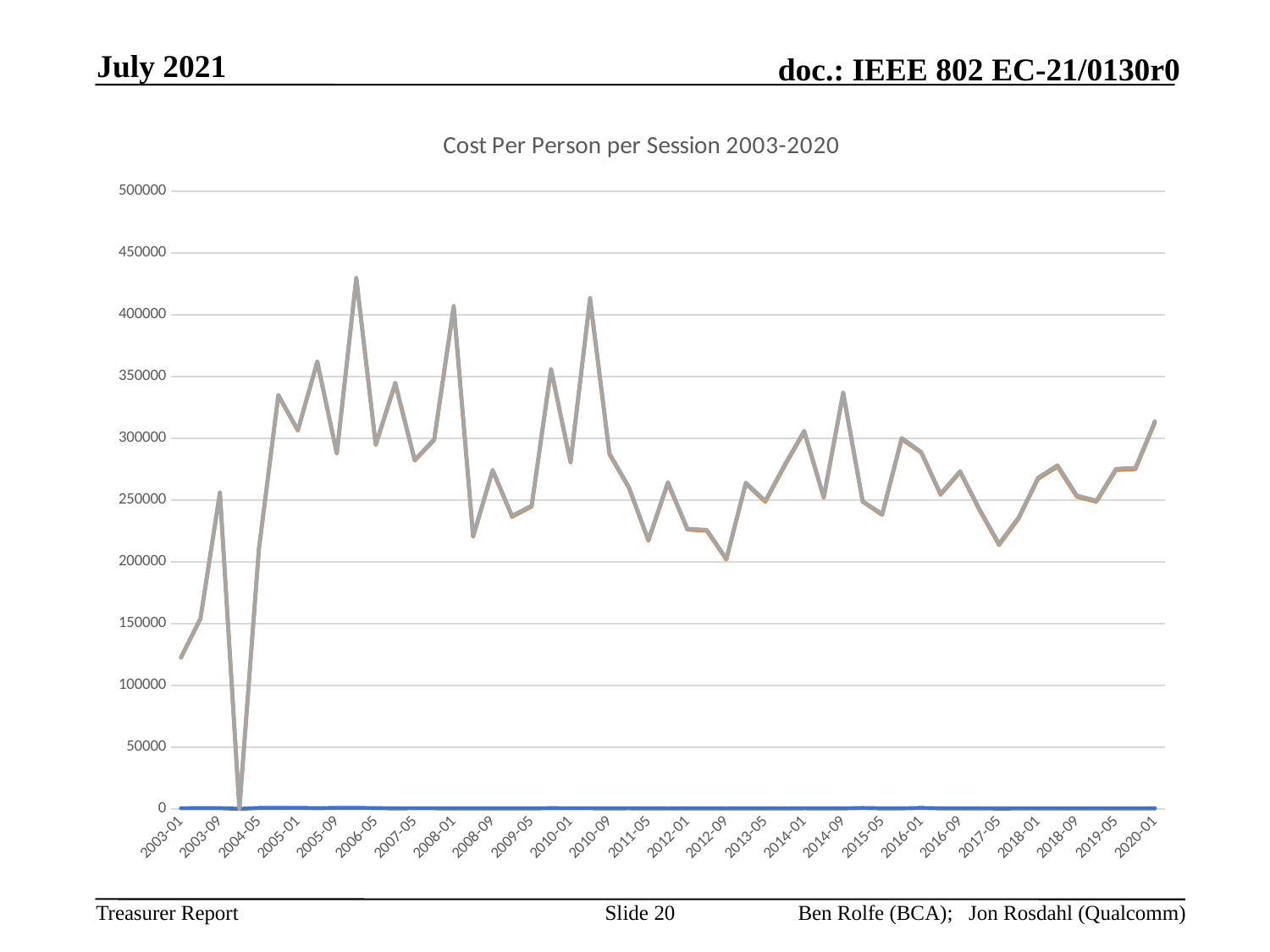
Is the value of the grey line at 2003-01 greater or less than 100000? greater Is the value of the grey line at 2005-01 greater or less than 300000? greater Is the value of the grey line at 2003-01 greater or less than 150000? less Which is larger on the grey line, the value at 2005-01 or the value at 2017-05? 2005-01 Which is larger on the grey line, the value at 2003-01 or the value at 2020-01? 2020-01 What kind of chart is shown on the slide? line chart What is the title of the chart? Cost Per Person per Session 2003-2020 Between 2017-05 and 2020-01, does the grey line generally rise or fall? rise